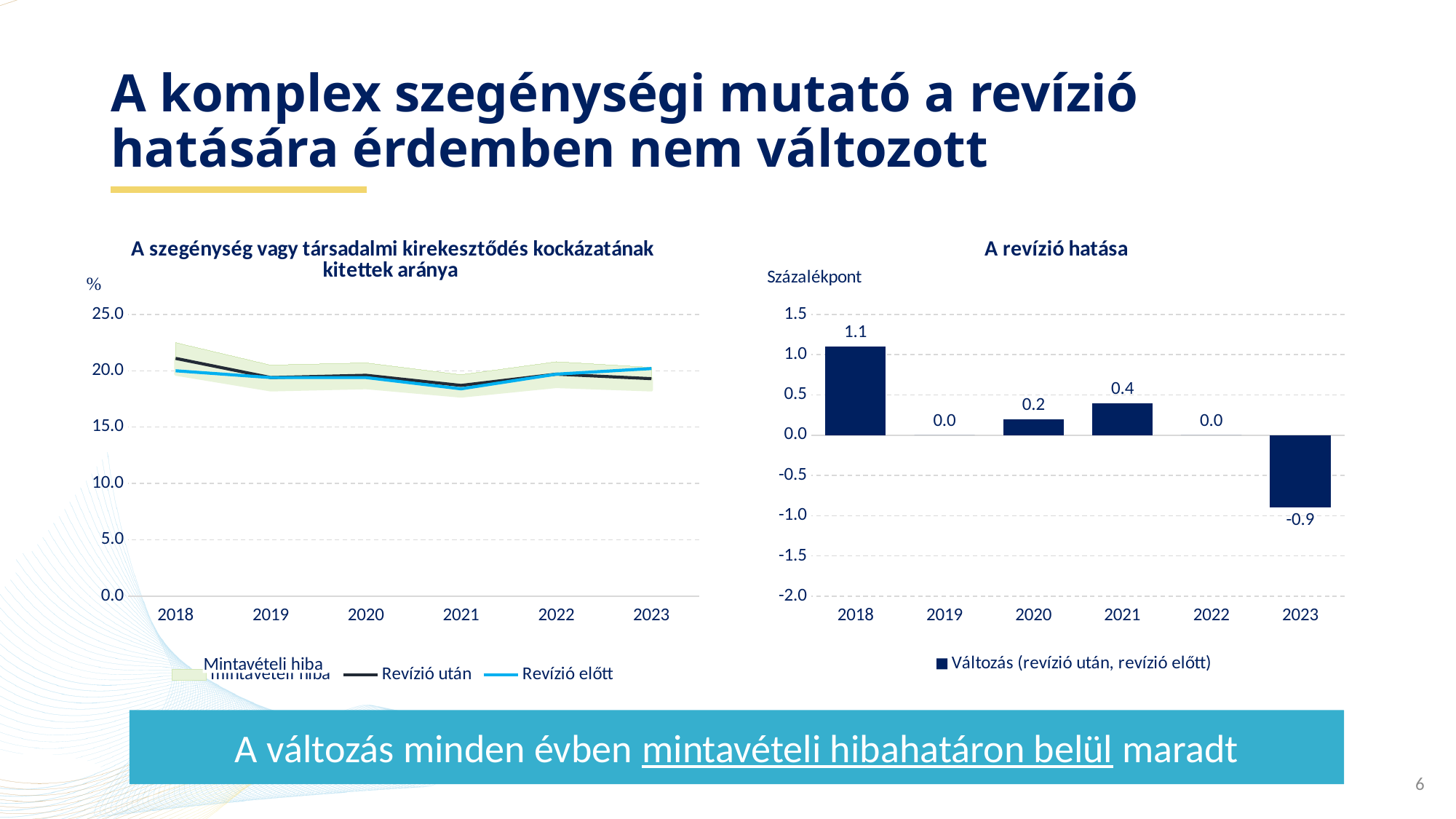
In the chart titled "A revízió hatása", which year has the lowest value? 2023 In the left chart titled "A szegénység vagy társadalmi kirekesztődés kockázatának kitettek aránya", is the value of "Revízió után" for 2018 greater or less than 20.0? greater In the chart titled "A revízió hatása", what is the value for 2018? 1.1 In the left chart titled "A szegénység vagy társadalmi kirekesztődés kockázatának kitettek aránya", is the value of "Revízió előtt" for 2021 greater or less than 20.0? less In the chart titled "A revízió hatása", how many years are shown on the x axis? 6 In the chart titled "A revízió hatása", which year has the highest value? 2018 What kind of chart is the chart titled "A revízió hatása"? bar chart In the chart titled "A revízió hatása", what is the difference between the values for 2018 and 2021? 0.7 In the chart titled "A revízió hatása", what is the value for 2021? 0.4 In the left chart titled "A szegénység vagy társadalmi kirekesztődés kockázatának kitettek aránya", how many series does the legend list? 3 In the chart titled "A revízió hatása", what is the value for 2023? -0.9 In the chart titled "A revízió hatása", which is larger, the value for 2020 or the value for 2021? 2021